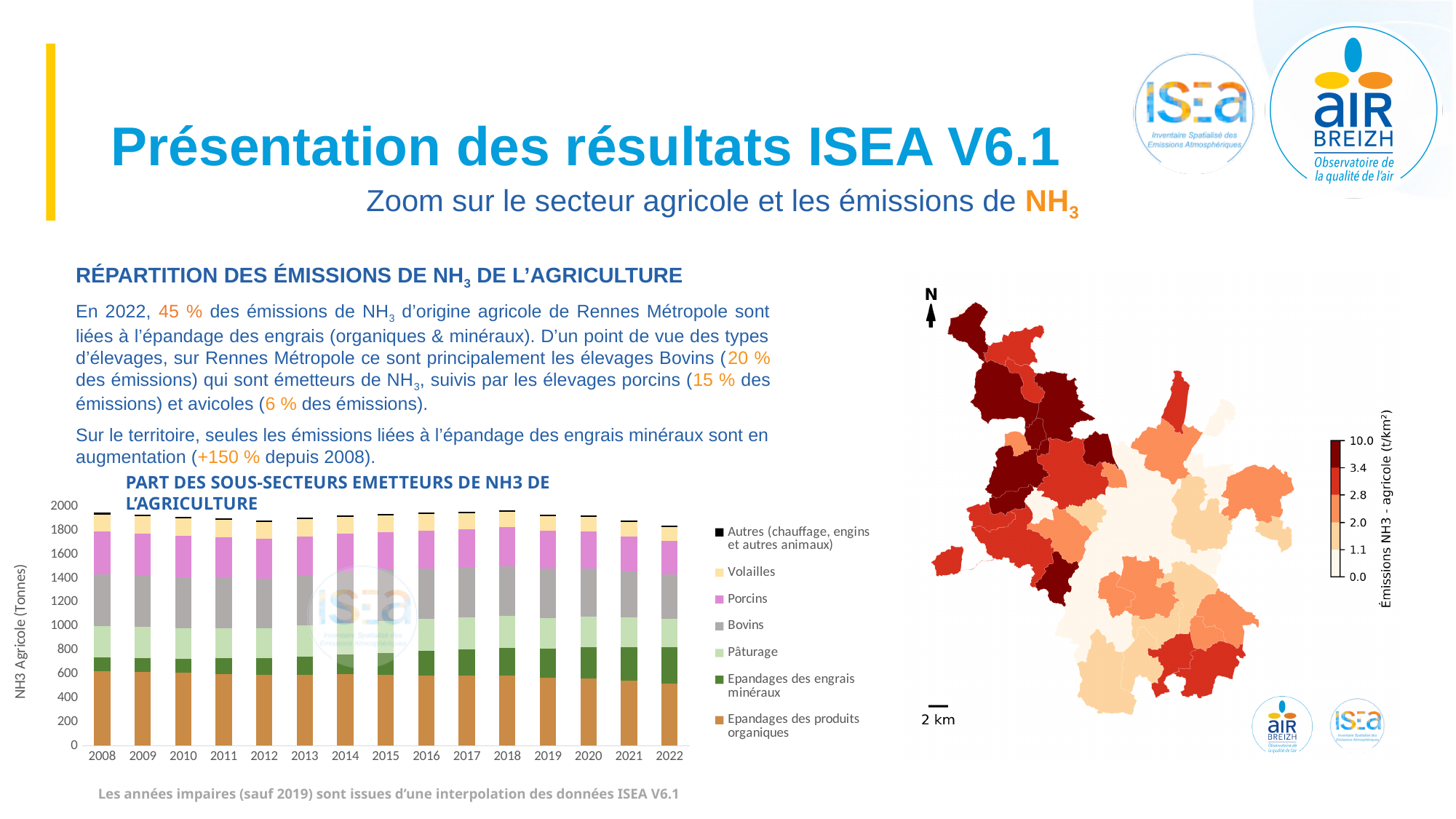
What is the label of the y axis of the bar chart? NH3 Agricole (Tonnes) What is the highest value shown on the y axis of the bar chart? 2000 In the bar chart, is the total height of the 2018 bar greater or less than 2000? less In the bar chart, is the total height of the 2008 bar greater or less than 1800? greater What is the first year shown on the x axis of the bar chart? 2008 What is the title of the bar chart? PART DES SOUS-SECTEURS EMETTEURS DE NH3 DE L'AGRICULTURE What kind of chart is shown at the bottom left of the slide? Stacked bar chart In the bar chart, is the 'Epandages des produits organiques' segment for 2008 greater or less than 400? greater How many series does the legend of the bar chart list? 7 What is the last year shown on the x axis of the bar chart? 2022 How many years are shown on the x axis of the bar chart? 15